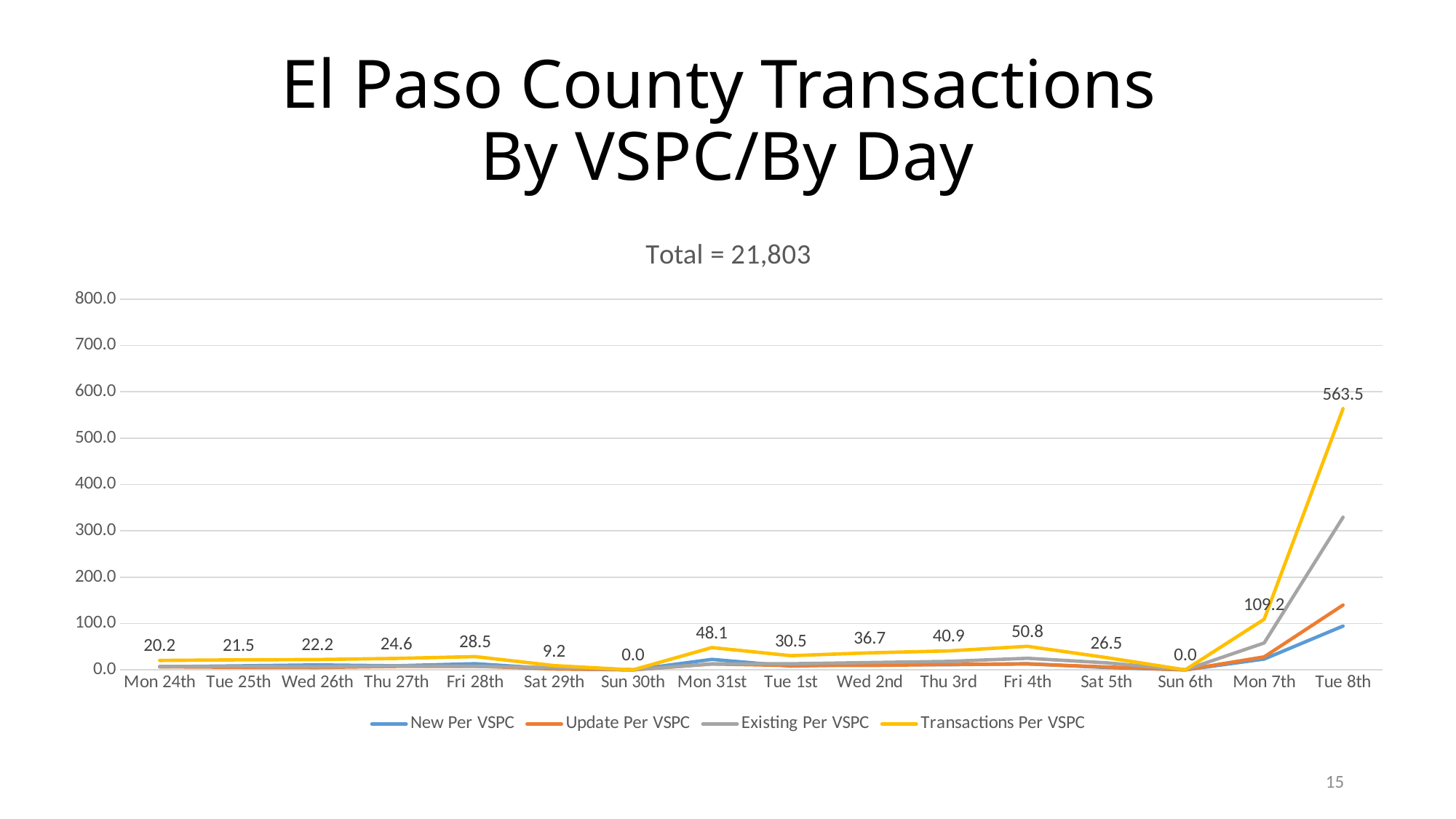
How many days are shown on the x axis? 16 What total is stated above the chart? Total = 21,803 On which day is Transactions Per VSPC highest? Tue 8th What is the value of Transactions Per VSPC on Tue 8th? 563.5 Which is larger for Transactions Per VSPC: Mon 31st or Tue 1st? Mon 31st What is the lowest value shown for Transactions Per VSPC? 0.0 Is the value for Existing Per VSPC on Tue 8th greater or less than 300? greater What kind of chart is shown on the slide? Line chart What is the difference between Transactions Per VSPC on Tue 8th and Mon 7th? 454.3 What is the value of Transactions Per VSPC on Mon 7th? 109.2 How many series does the legend list? 4 What is the value of Transactions Per VSPC on Fri 4th? 50.8